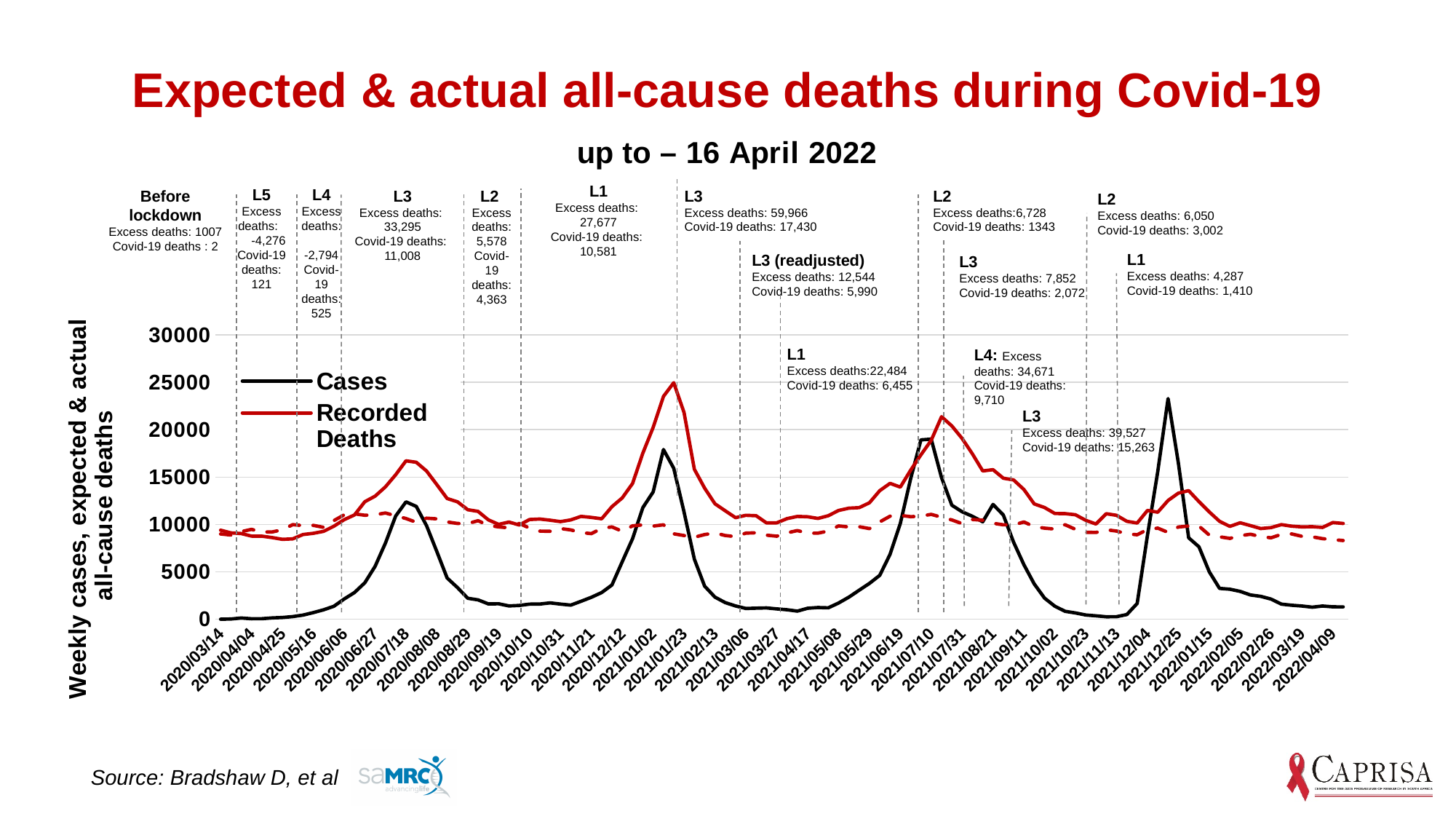
How many series does the chart's legend list? 2 How many excess deaths are listed for the 'L3 (readjusted)' period? 12,544 At the peak around 2021/01/23, which line is higher: Cases or Recorded Deaths? Recorded Deaths According to the annotation for the first L3 period (around 2020/06–2020/08), how many excess deaths were there? 33,295 For the L3 period with 59,966 excess deaths and 17,430 Covid-19 deaths, what is the difference between excess deaths and Covid-19 deaths? 42,536 What is the label on the vertical axis of the chart? Weekly cases, expected & actual all-cause deaths How many excess deaths are listed for the L4 period in mid-2021? 34,671 How many Covid-19 deaths are listed for the 'Before lockdown' period? 2 Is the peak of the Recorded Deaths line around 2021/01/23 greater or less than 20000? greater In the L3 period annotated with 59,966 excess deaths, how many Covid-19 deaths are listed? 17,430 Is the peak of the Cases line around 2021/12/25 greater or less than 20000? greater What kind of chart is shown on the slide? line chart